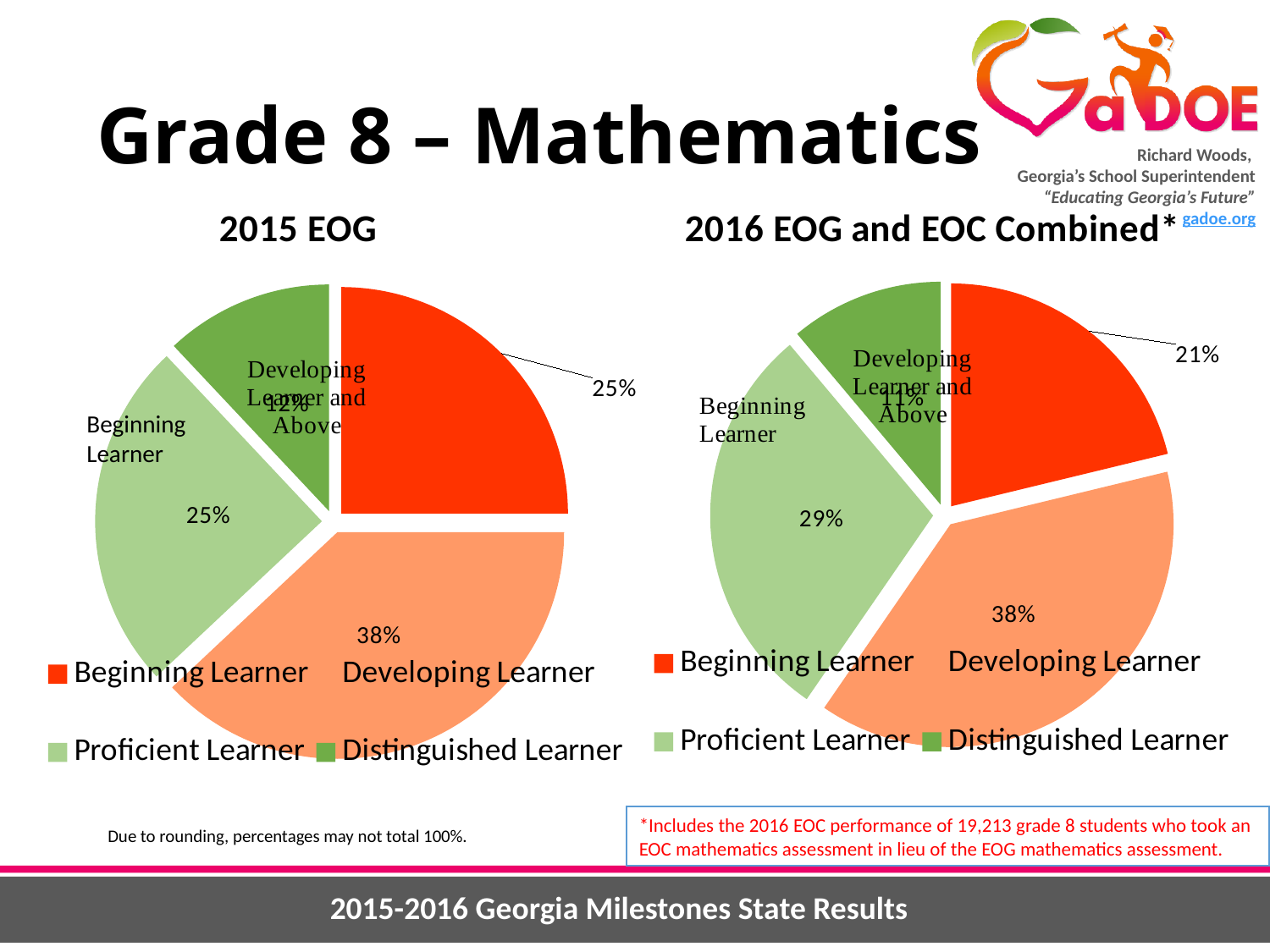
How many categories does the 2015 EOG chart show? 4 In the 2016 EOG and EOC Combined chart, what percentage of students were Proficient Learners? 29% In the 2015 EOG chart, which category has the smallest share? Distinguished Learner Which is larger in the 2016 EOG and EOC Combined chart: the Proficient Learner share or the Beginning Learner share? Proficient Learner In the 2016 EOG and EOC Combined chart, what percentage of students were Beginning Learners? 21% What type of chart is the 2015 EOG chart? Pie chart What is the title of the chart on the right side of the slide? 2016 EOG and EOC Combined* How many entries does the legend of the 2016 EOG and EOC Combined chart list? 4 In the 2015 EOG chart, what percentage of students were Developing Learners? 38% In the 2015 EOG chart, what percentage of students were Beginning Learners? 25% In the 2016 EOG and EOC Combined chart, what is the difference between the Developing Learner share and the Beginning Learner share? 17% In the 2016 EOG and EOC Combined chart, which category has the largest share? Developing Learner